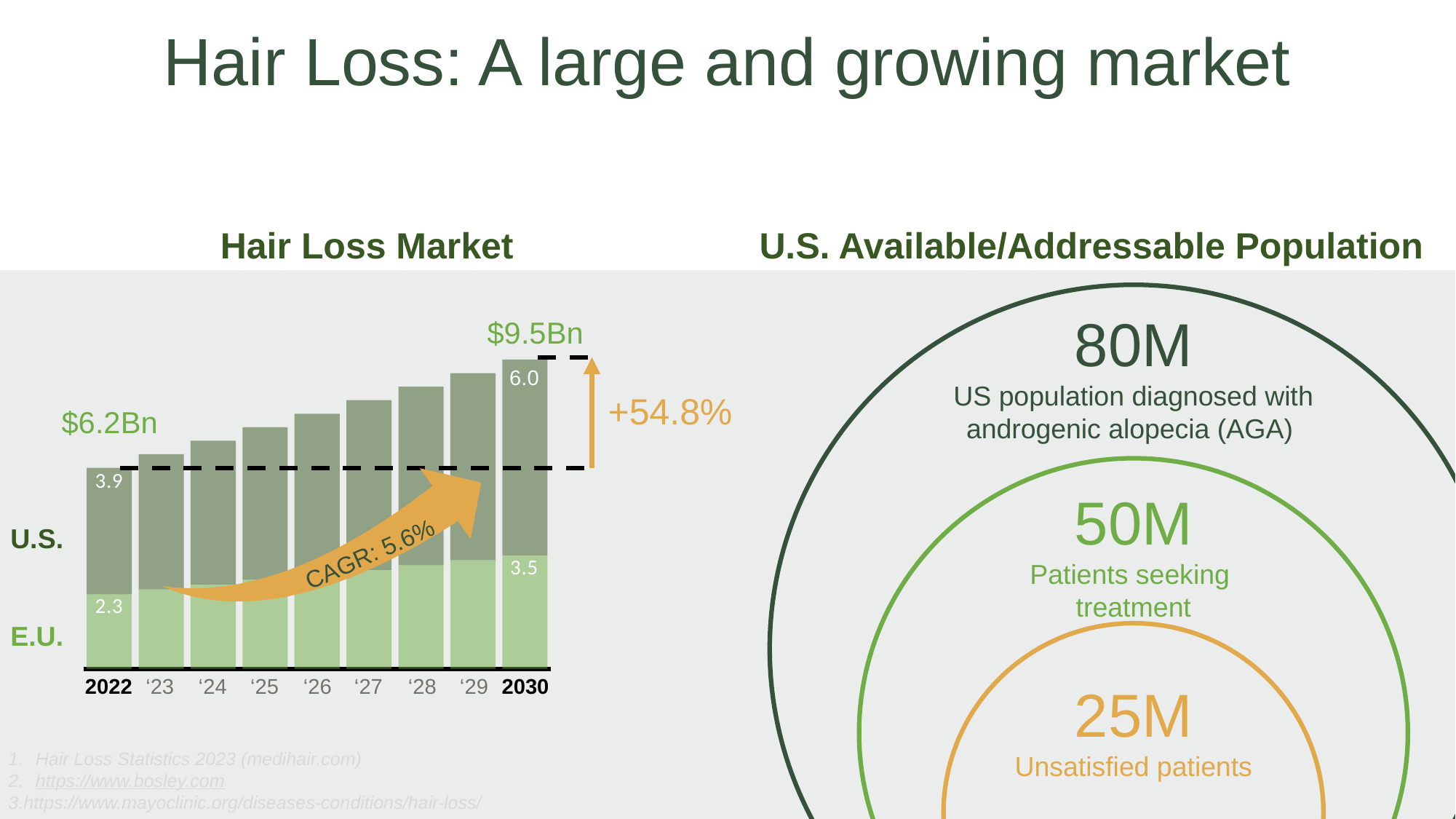
In the Hair Loss Market chart, what is the U.S. value for 2022? 3.9 In the Hair Loss Market chart, what is the E.U. value for 2022? 2.3 What kind of chart is the Hair Loss Market chart? Stacked bar chart How many years are shown on the x axis of the Hair Loss Market chart? 9 In the Hair Loss Market chart, by how much does the U.S. value in 2030 exceed the U.S. value in 2022? 2.1 In the Hair Loss Market chart, what is the U.S. value for 2030? 6.0 In the Hair Loss Market chart, what is the E.U. value for 2030? 3.5 In the Hair Loss Market chart, do the total bar heights rise or fall from 2022 to 2030? Rise How many series are shown in the Hair Loss Market chart? 2 In the Hair Loss Market chart, what is the total market size shown for 2022? $6.2Bn In the Hair Loss Market chart, which is larger in 2030, the U.S. value or the E.U. value? U.S. In the Hair Loss Market chart, what is the total market size shown for 2030? $9.5Bn